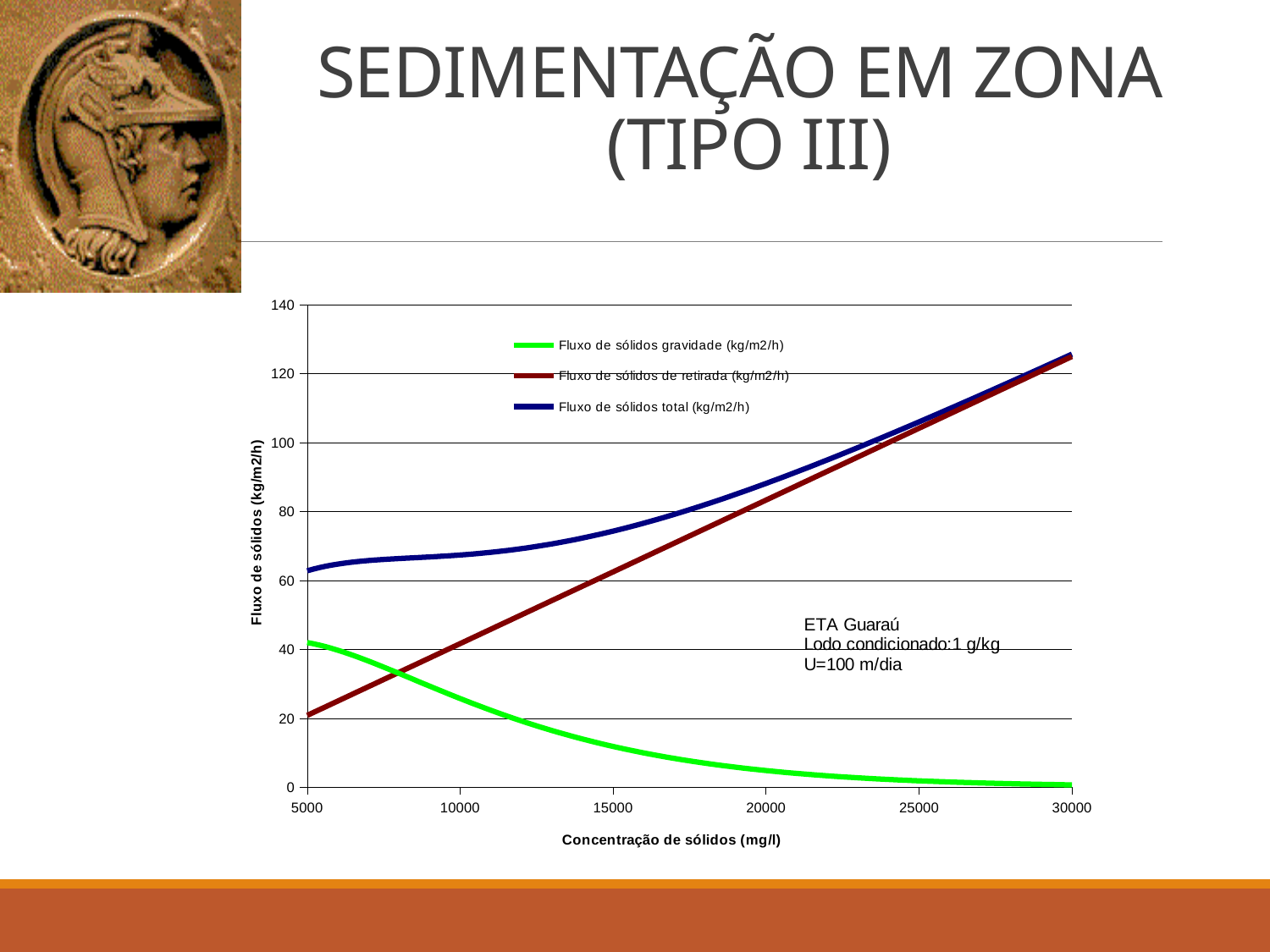
At a concentration of 5000 mg/l, which series has the larger value: 'Fluxo de sólidos gravidade (kg/m2/h)' or 'Fluxo de sólidos de retirada (kg/m2/h)'? Fluxo de sólidos gravidade (kg/m2/h) Does the 'Fluxo de sólidos total (kg/m2/h)' series rise or fall as the concentration increases along the x axis? rise What kind of chart is shown on the slide? line chart At a concentration of 10000 mg/l, which series has the larger value: 'Fluxo de sólidos total (kg/m2/h)' or 'Fluxo de sólidos de retirada (kg/m2/h)'? Fluxo de sólidos total (kg/m2/h) Does the 'Fluxo de sólidos gravidade (kg/m2/h)' series rise or fall as the concentration increases along the x axis? fall Is the value of 'Fluxo de sólidos gravidade (kg/m2/h)' at a concentration of 20000 mg/l greater or less than 20? less Does the 'Fluxo de sólidos de retirada (kg/m2/h)' series rise or fall as the concentration increases along the x axis? rise How many series does the legend list? 3 Is the value of 'Fluxo de sólidos de retirada (kg/m2/h)' at a concentration of 30000 mg/l greater or less than 120? greater Is the value of 'Fluxo de sólidos gravidade (kg/m2/h)' at a concentration of 10000 mg/l greater or less than 40? less What is the title of the x axis of the chart? Concentração de sólidos (mg/l)